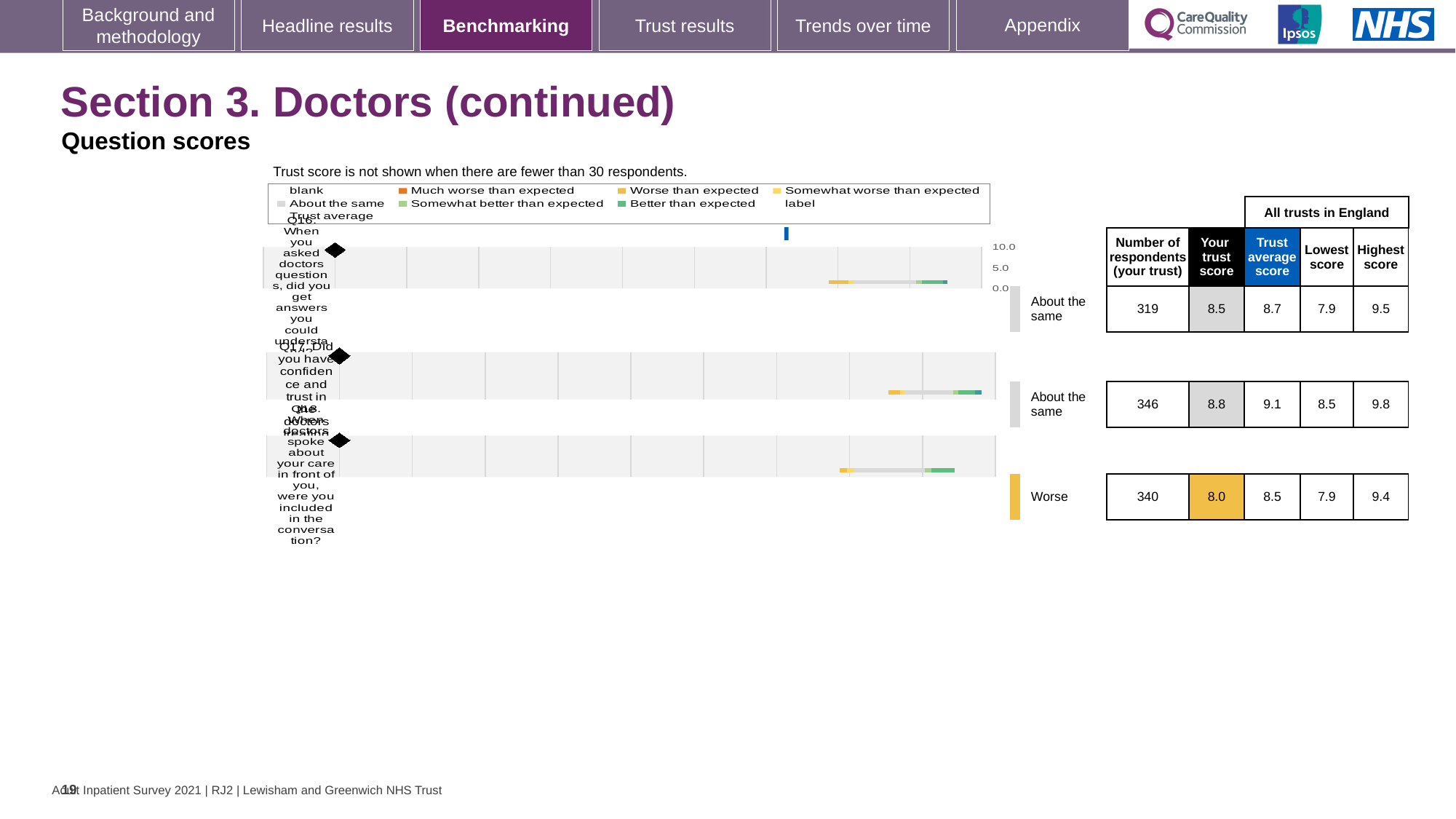
What benchmark category is shown for Q18? Worse Which is larger: your trust score for Q16 or for Q17? Q17 How many respondents from your trust answered Q16 (When you asked doctors questions, did you get answers you could understand)? 319 What is your trust score for Q17 (Did you have confidence and trust in the doctors treating you)? 8.8 What kind of chart is used to show the question scores? Bar chart What is the highest score across all trusts in England for Q17? 9.8 What is the difference between the trust average score and your trust score for Q18? 0.5 Which question has the highest 'Your trust score'? Q17 What is the lowest score across all trusts in England for Q16? 7.9 Which question has the lowest 'Your trust score'? Q18 What is the trust average score for Q18 (When doctors spoke about your care in front of you, were you included in the conversation)? 8.5 How many questions are plotted in the chart? 3